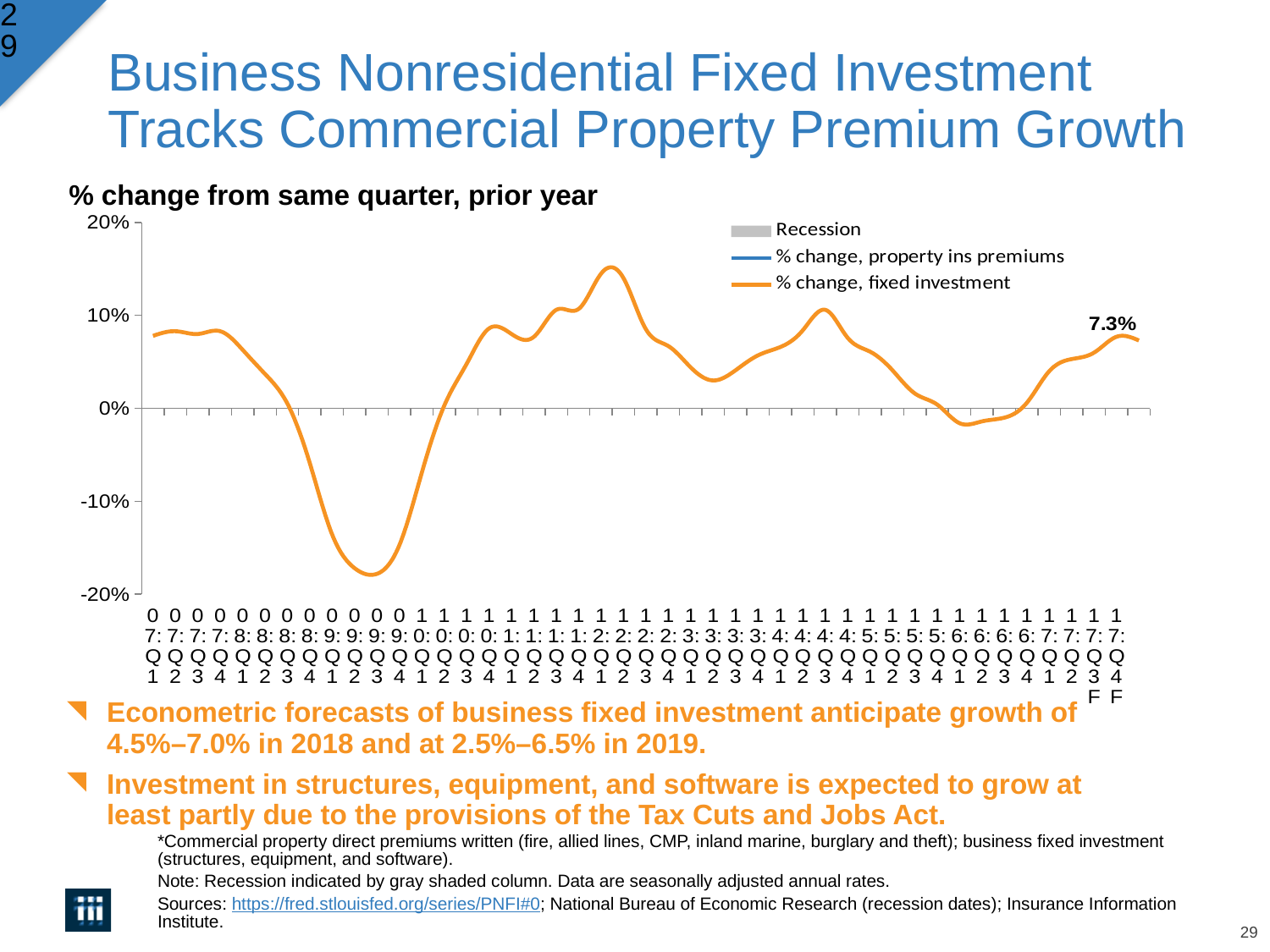
Is the value for fixed investment at 17:Q4F greater or less than 5%? greater What colour is the '% change, fixed investment' line? orange Is the value for fixed investment at 16:Q1 greater or less than 0%? less Which is larger: the fixed investment value at 07:Q1 or at 09:Q2? 07:Q1 What is the label above the chart describing the measure plotted? % change from same quarter, prior year What kind of chart is shown on the slide? line chart How many entries does the chart legend list? 3 Is the value for fixed investment at 09:Q2 greater or less than -10%? less What value is printed as a data label at the right end of the fixed investment line? 7.3% Do the fixed investment values rise or fall from 08:Q1 to 09:Q2? fall